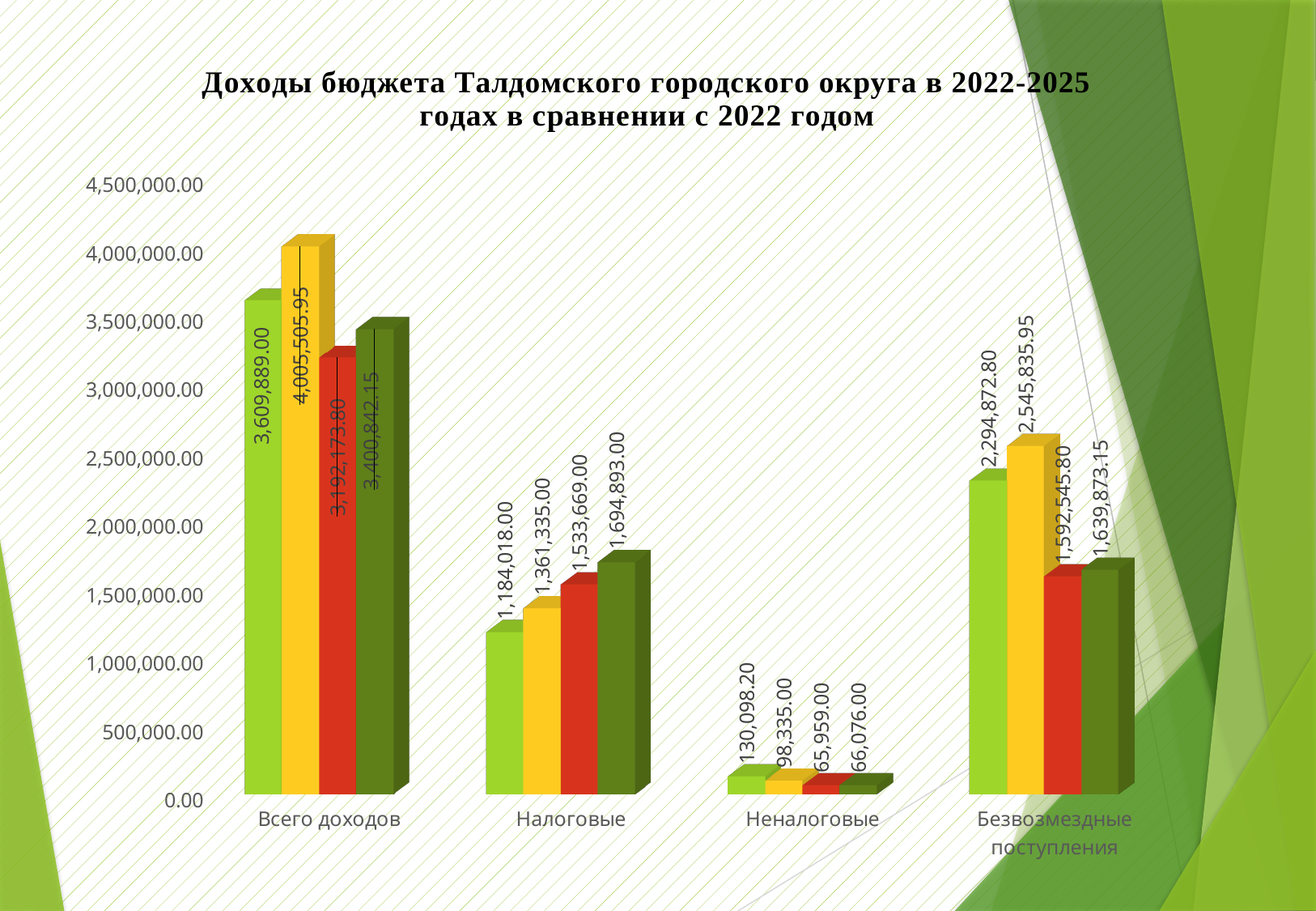
Which bar in the Всего доходов group is the highest? The yellow (second) bar, 4,005,505.95 What is the value of the red (third) bar for Неналоговые? 65,959.00 What is the difference between the yellow bar and the red bar for Всего доходов? 813,332.15 How many categories are shown on the x axis? 4 Do the values for Налоговые rise or fall from the first bar to the fourth bar? Rise What kind of chart is shown on the slide? Bar chart Which category has the lowest values overall? Неналоговые What is the value of the light green (first) bar for Всего доходов? 3,609,889.00 Which is larger for Безвозмездные поступления: the light green bar or the red bar? The light green bar (2,294,872.80) What is the value of the yellow (second) bar for Безвозмездные поступления? 2,545,835.95 Is the value of the yellow bar for Всего доходов greater or less than 4,000,000.00? greater What is the value of the dark green (fourth) bar for Налоговые? 1,694,893.00